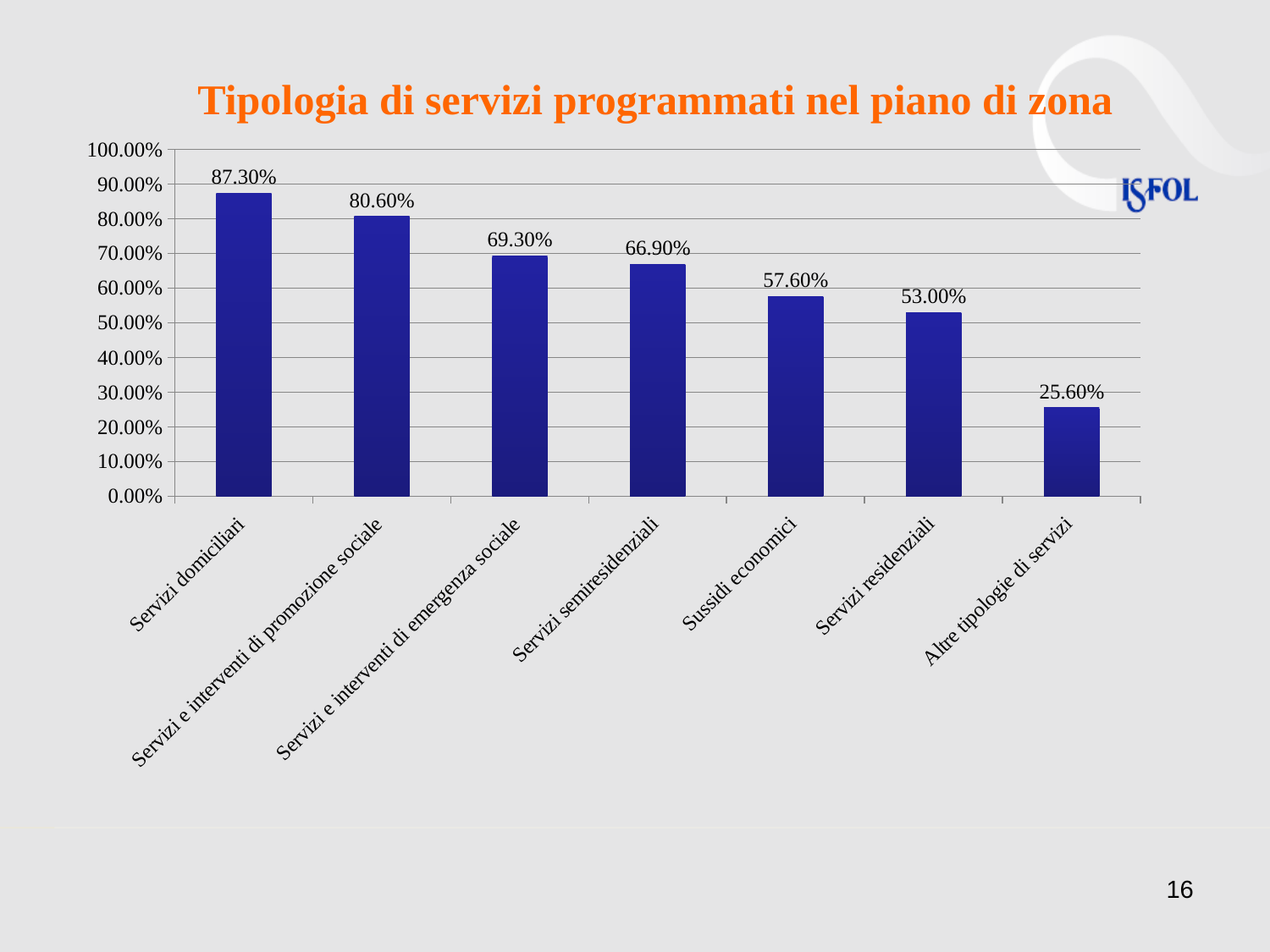
What is the value for Servizi domiciliari? 87.30% How many categories are shown in the chart? 7 Do the values rise or fall from left to right along the x axis? Fall Is the value for Servizi e interventi di promozione sociale greater or less than 80.00%? greater What is the difference between Servizi domiciliari and Servizi residenziali? 34.30% Which category has the lowest value? Altre tipologie di servizi Which is larger: Servizi e interventi di emergenza sociale or Servizi semiresidenziali? Servizi e interventi di emergenza sociale Which category has the highest value? Servizi domiciliari What is the title of the chart? Tipologia di servizi programmati nel piano di zona What is the value for Altre tipologie di servizi? 25.60% What kind of chart is shown on the slide? Bar chart What is the value for Sussidi economici? 57.60%